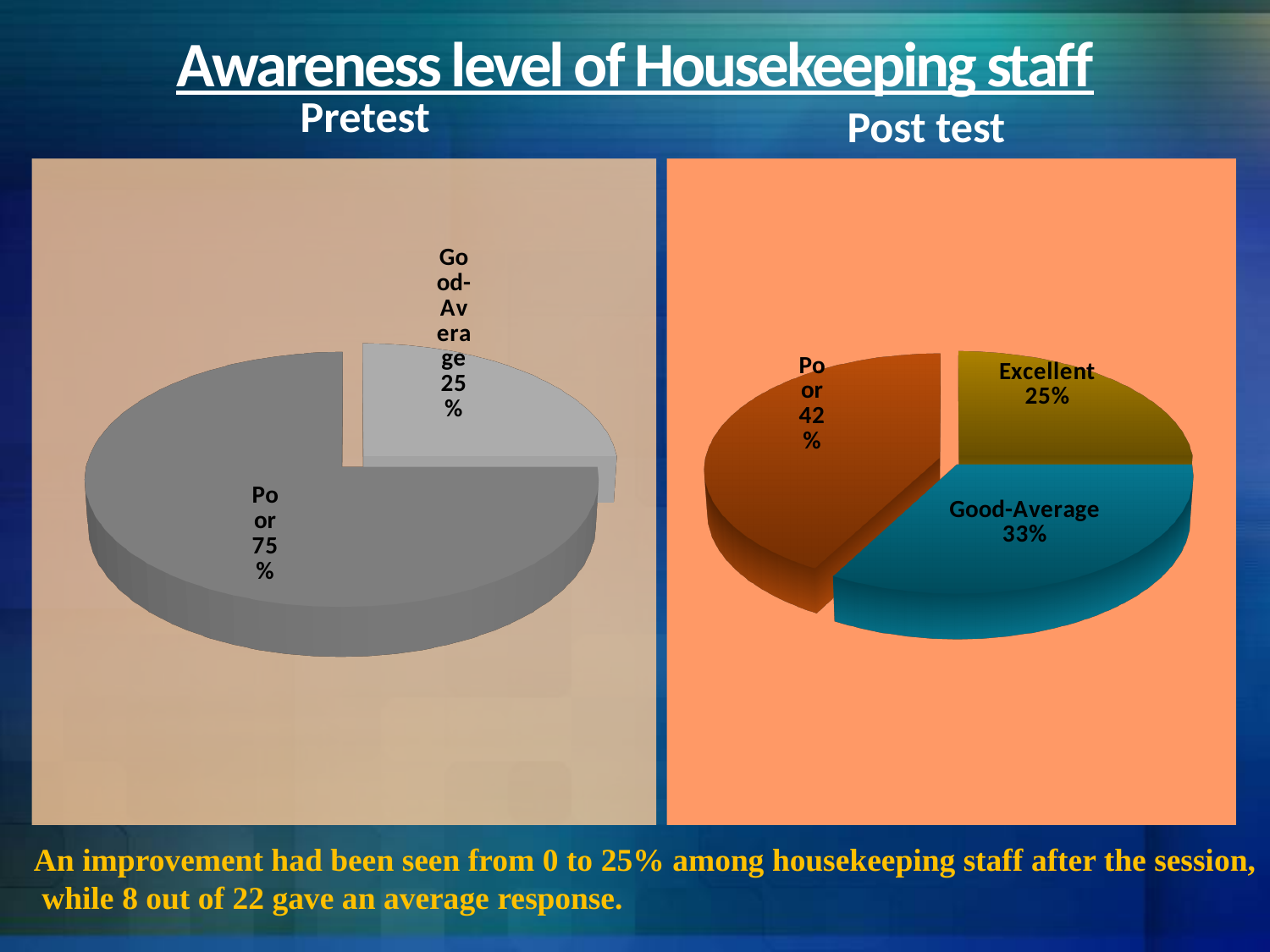
In the Post test chart, which category has the smallest slice? Excellent What is the difference between the Poor share in the Pretest chart and the Poor share in the Post test chart? 33% In the Pretest chart, what percentage is labelled Good-Average? 25% In the Post test chart, which category has the largest slice? Poor What kind of chart is the Pretest chart? Pie chart How many slices does the Post test chart have? 3 How many slices does the Pretest chart have? 2 In the Pretest chart, what percentage is labelled Poor? 75% In the Pretest chart, which category has the larger slice? Poor In the Post test chart, what percentage is labelled Poor? 42% In the Post test chart, what percentage is labelled Good-Average? 33% In the Post test chart, what percentage is labelled Excellent? 25%